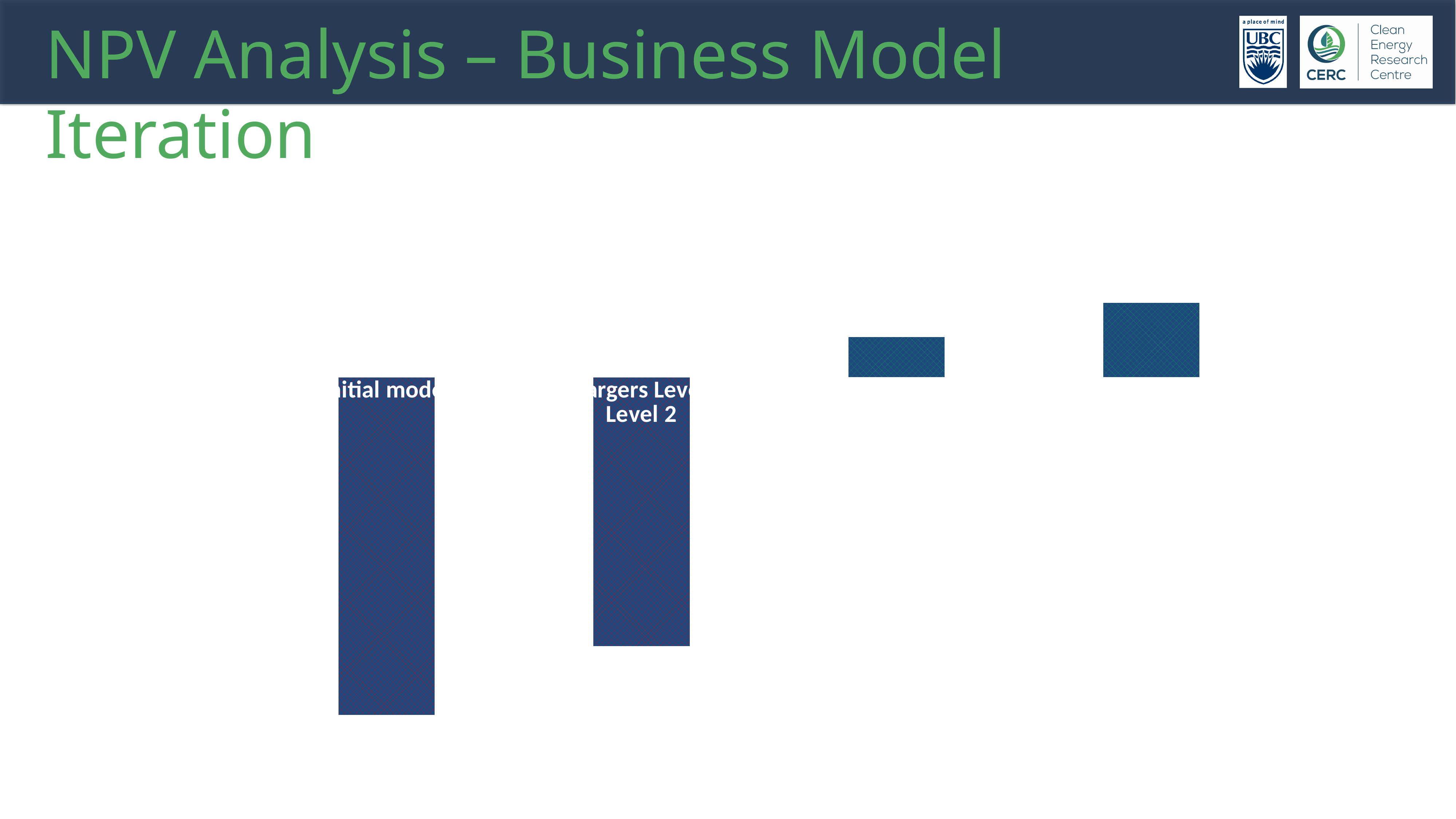
Is the value of the first bar from the left larger or smaller than the value of the second bar? smaller What is the title text shown at the top of the slide? NPV Analysis – Business Model Iteration How many bars does the chart contain? 4 How many bars extend above the baseline (positive values)? 2 Which bar has the lowest value: the first, second, third or fourth from the left? first Do the bar values rise or fall moving from left to right along the x axis? rise What kind of chart is shown on the slide? bar chart Which bar has the highest value: the first, second, third or fourth from the left? fourth Is the value of the fourth bar from the left larger or smaller than the value of the third bar? larger How many bars extend below the baseline (negative values)? 2